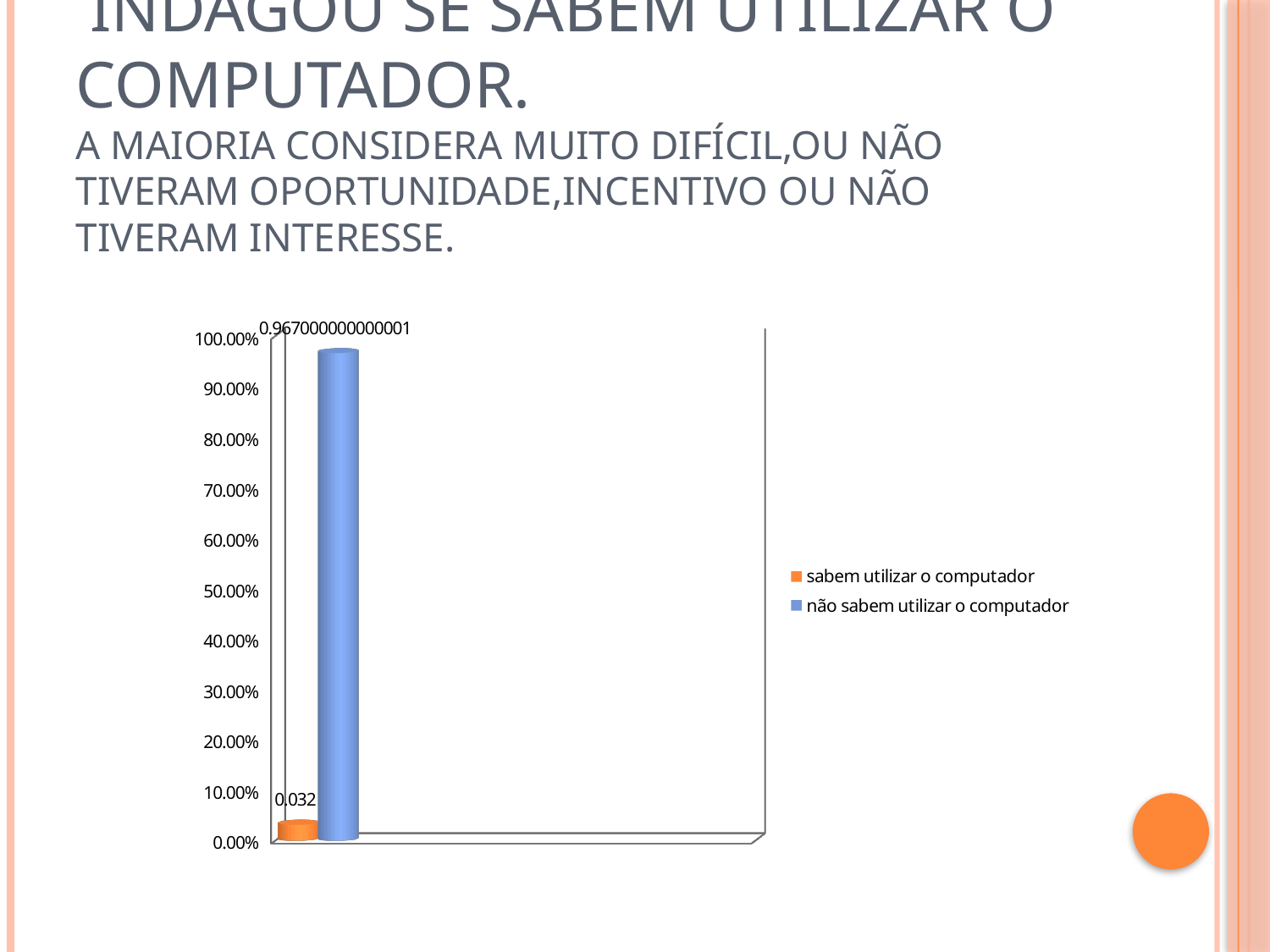
Which series has the tallest bar? não sabem utilizar o computador How many bars are plotted in the chart? 2 What data label is shown on the bar for "sabem utilizar o computador"? 0.032 How many series does the legend list? 2 Which is larger: the bar for "sabem utilizar o computador" or the bar for "não sabem utilizar o computador"? não sabem utilizar o computador Is the bar for "sabem utilizar o computador" greater or less than 10.00%? less Is the bar for "não sabem utilizar o computador" greater or less than 90.00%? greater What is the highest value shown on the vertical axis? 100.00% What colour is the bar for "não sabem utilizar o computador"? blue What kind of chart is shown on the slide? bar chart Which series has the shortest bar? sabem utilizar o computador What data label is shown on the bar for "não sabem utilizar o computador"? 0.967000000000001